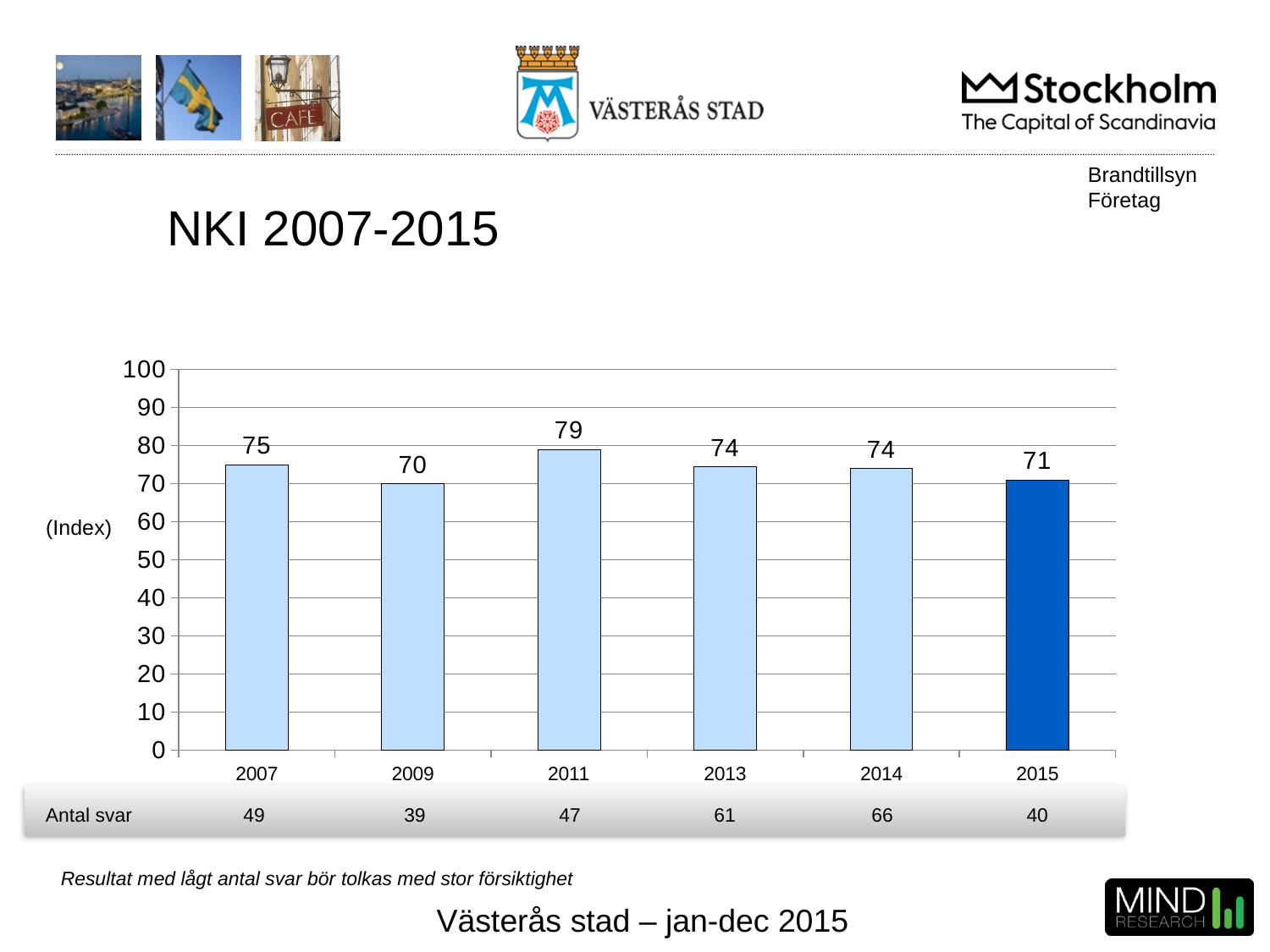
What is the NKI index value for 2015? 71 What is the NKI index value for 2009? 70 What is the difference between the NKI index values for 2011 and 2015? 8 Which bar in the chart is shown in a darker blue colour than the others? 2015 How many years are shown on the x axis of the chart? 6 What is the 'Antal svar' (number of responses) for 2014? 66 Which year has a higher NKI index value, 2007 or 2009? 2007 Does the NKI index value rise or fall from 2014 to 2015? Fall Which year has the lowest NKI index value? 2009 What is the NKI index value for 2011? 79 Which year has the highest NKI index value? 2011 What kind of chart is shown on the slide? Bar chart